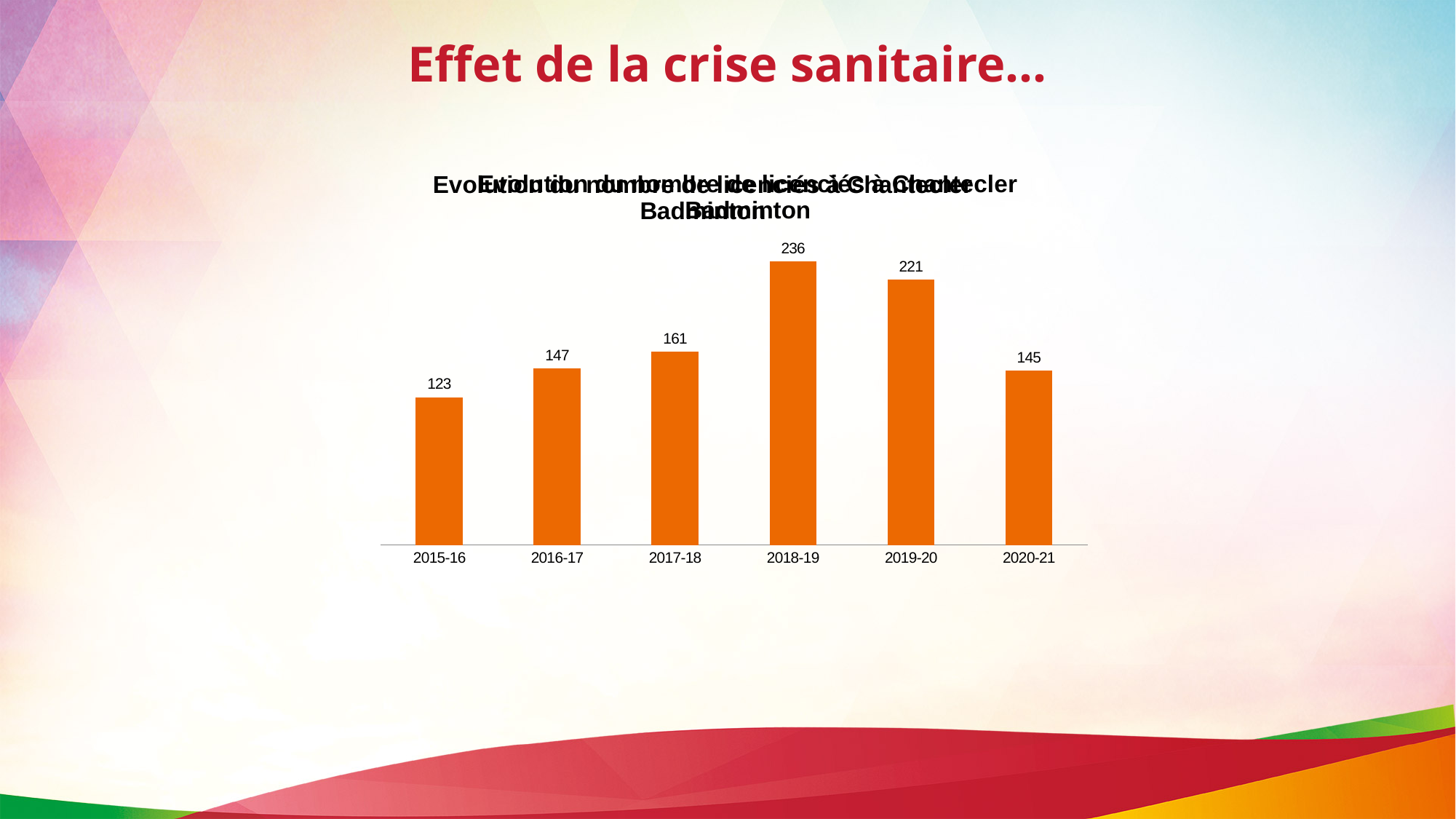
What is the difference between the values for 2019-20 and 2020-21? 76 What is the value for 2015-16? 123 What is the value for 2020-21? 145 What is the value for 2017-18? 161 What kind of chart is shown on the slide? Bar chart Which is larger, the value for 2016-17 or the value for 2020-21? 2016-17 Which season has the lowest value? 2015-16 What is the difference between the values for 2018-19 and 2015-16? 113 How many seasons are shown on the x axis? 6 Which season has the highest value? 2018-19 Do the values rise or fall from 2015-16 to 2018-19? Rise What is the value for 2018-19? 236